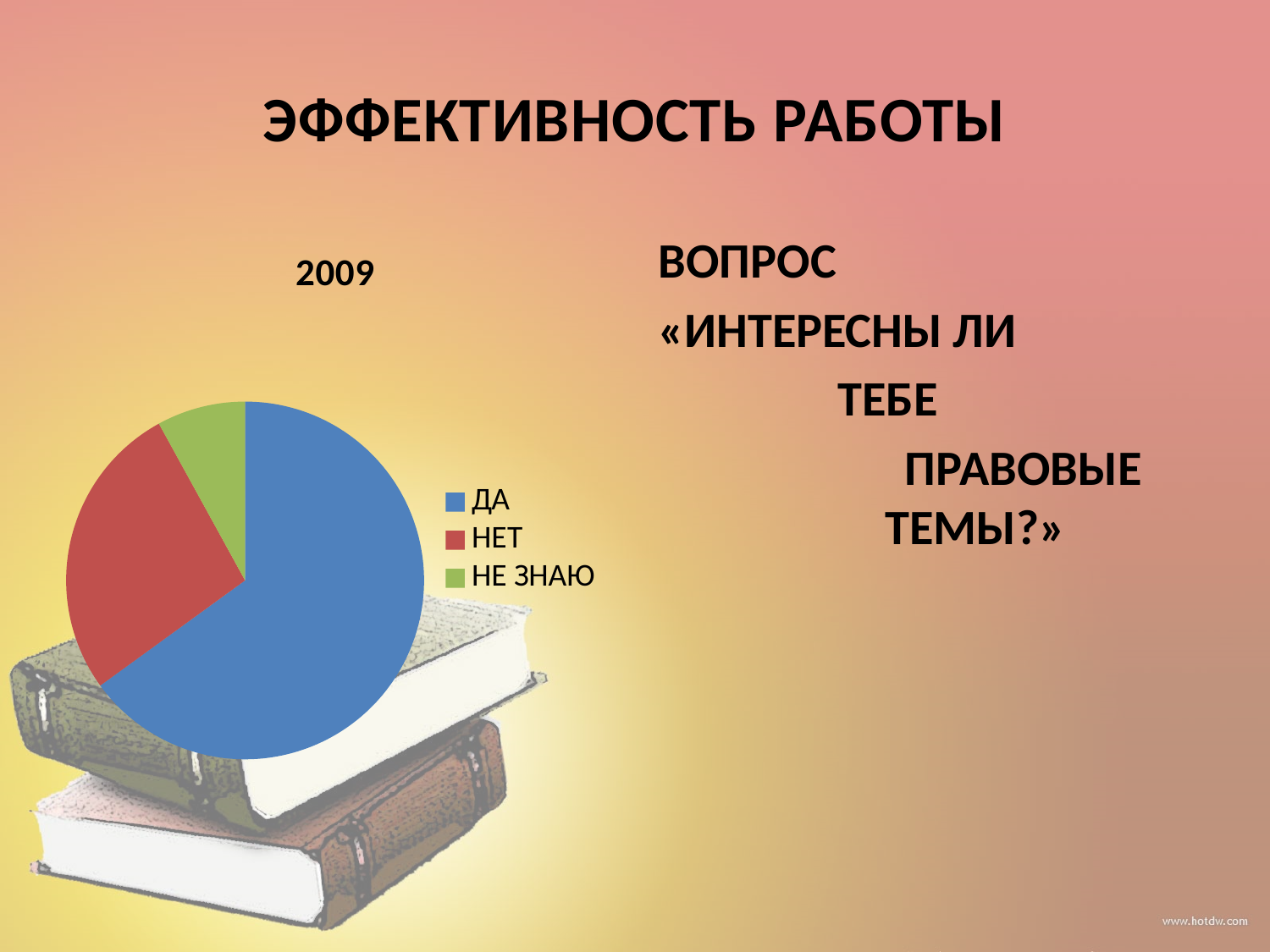
What is the title of the pie chart? 2009 Which slice is larger in the pie chart, ДА or НЕТ? ДА Which category has the smallest slice in the pie chart? НЕ ЗНАЮ How many entries does the legend of the pie chart list? 3 Which slice is larger in the pie chart, НЕТ or НЕ ЗНАЮ? НЕТ Does the ДА slice take up more or less than half of the pie chart? more What kind of chart is shown on the slide? pie chart How many slices does the pie chart have? 3 Which category has the largest slice in the pie chart? ДА Which colour represents the category НЕТ in the pie chart? red